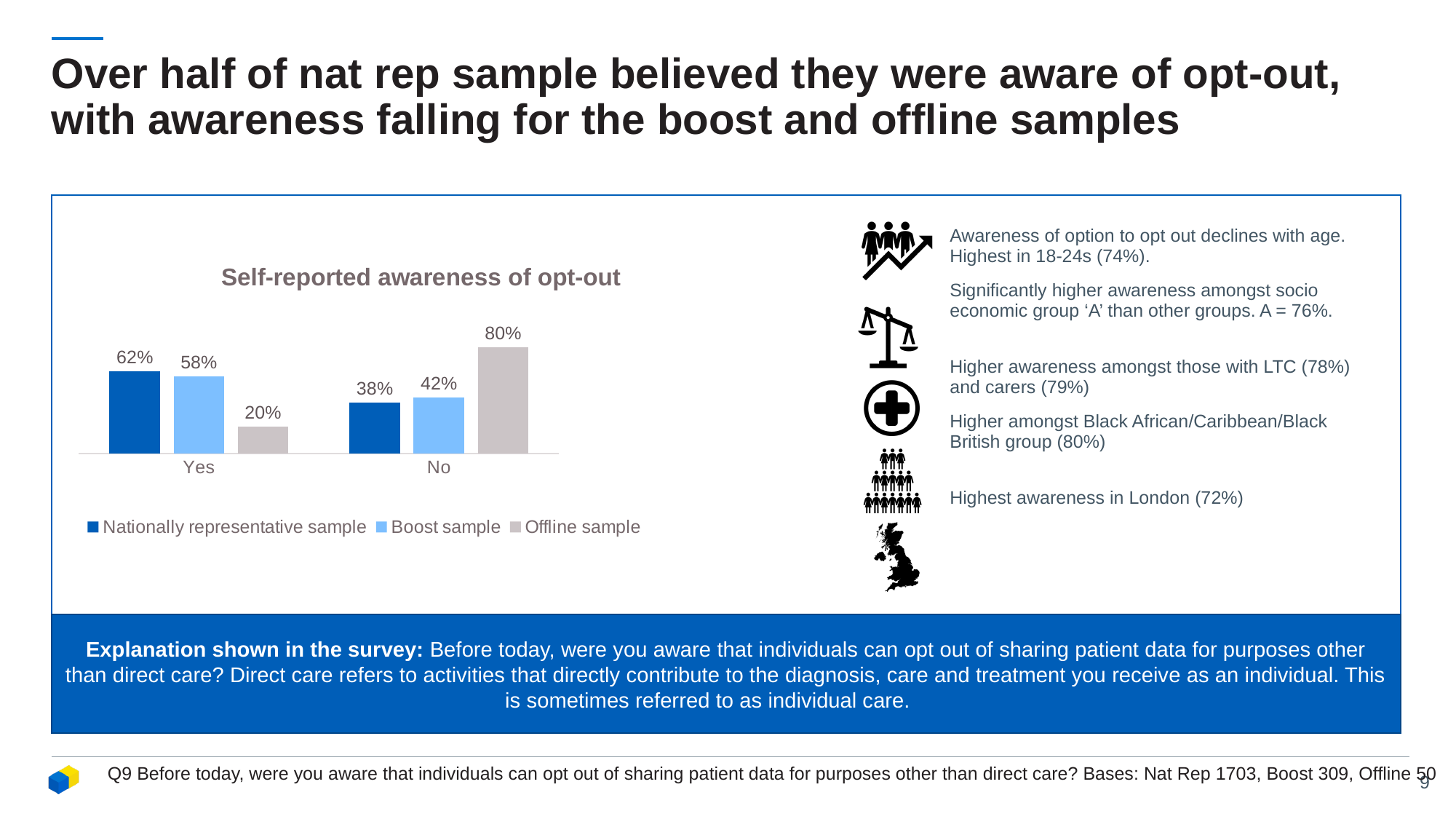
Which series has the highest value in the No category? Offline sample Which is larger: the Boost sample value for Yes or the Boost sample value for No? Yes How many series does the legend list? 3 Which series has the lowest value in the Yes category? Offline sample What is the value for the Offline sample in the No category? 80% What is the difference between the Nationally representative sample and the Offline sample in the Yes category? 42 percentage points What is the value for the Nationally representative sample in the Yes category? 62% What is the title of the chart? Self-reported awareness of opt-out What kind of chart is shown? Bar chart How many categories are shown on the x axis? 2 What is the value for the Boost sample in the Yes category? 58% What is the value for the Boost sample in the No category? 42%